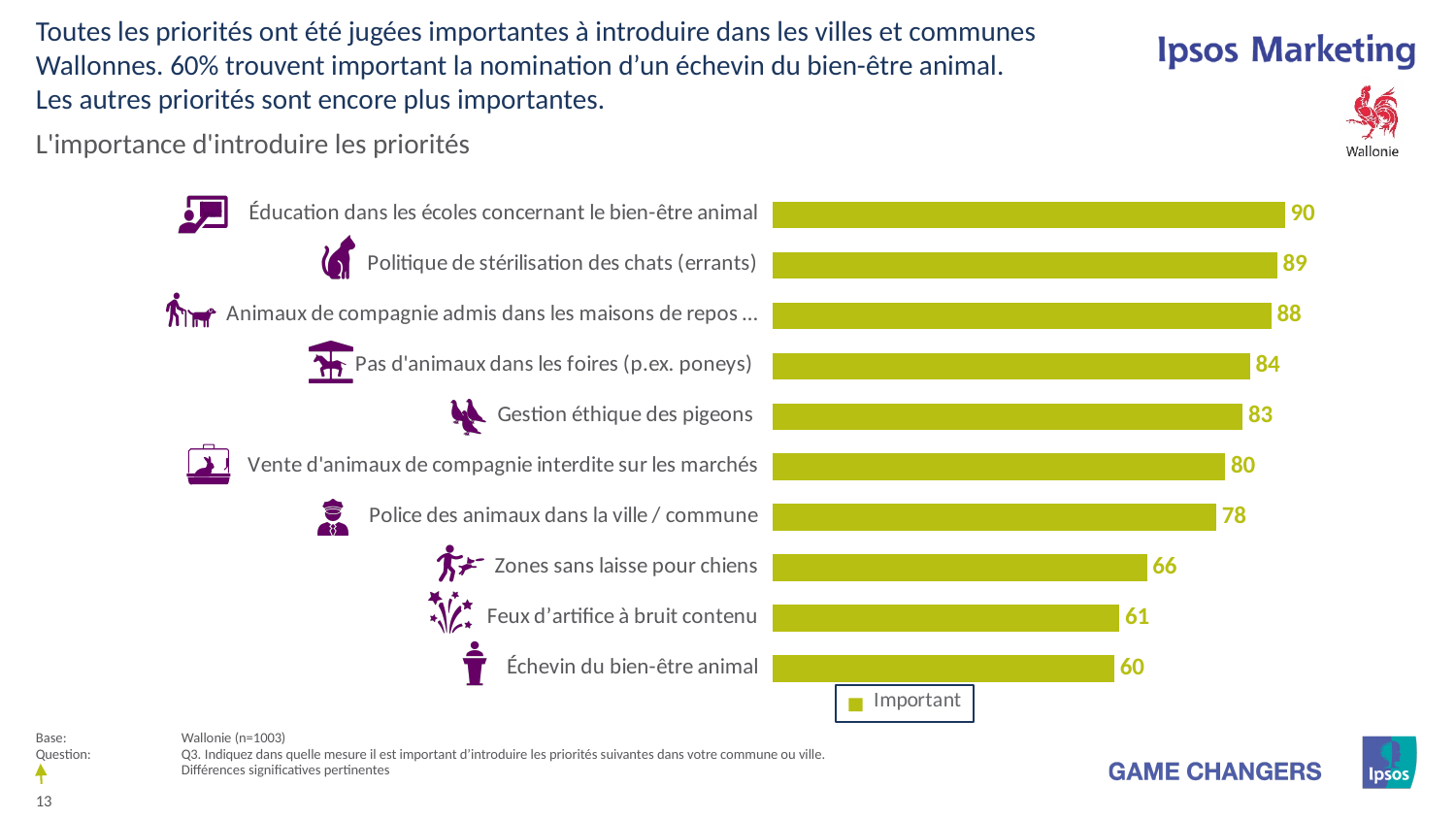
How many categories are shown in the chart? 10 What kind of chart is shown on the slide? Bar chart What is the difference between the values for "Politique de stérilisation des chats (errants)" and "Feux d'artifice à bruit contenu"? 28 What is the value for "Vente d'animaux de compagnie interdite sur les marchés"? 80 Which category has the lowest value? Échevin du bien-être animal How many series does the legend list? 1 What is the value for "Éducation dans les écoles concernant le bien-être animal"? 90 What is the name of the series shown in the legend? Important What is the value for "Zones sans laisse pour chiens"? 66 Which is larger: the value for "Gestion éthique des pigeons" or the value for "Police des animaux dans la ville / commune"? Gestion éthique des pigeons What is the value for "Échevin du bien-être animal"? 60 Which category has the highest value? Éducation dans les écoles concernant le bien-être animal